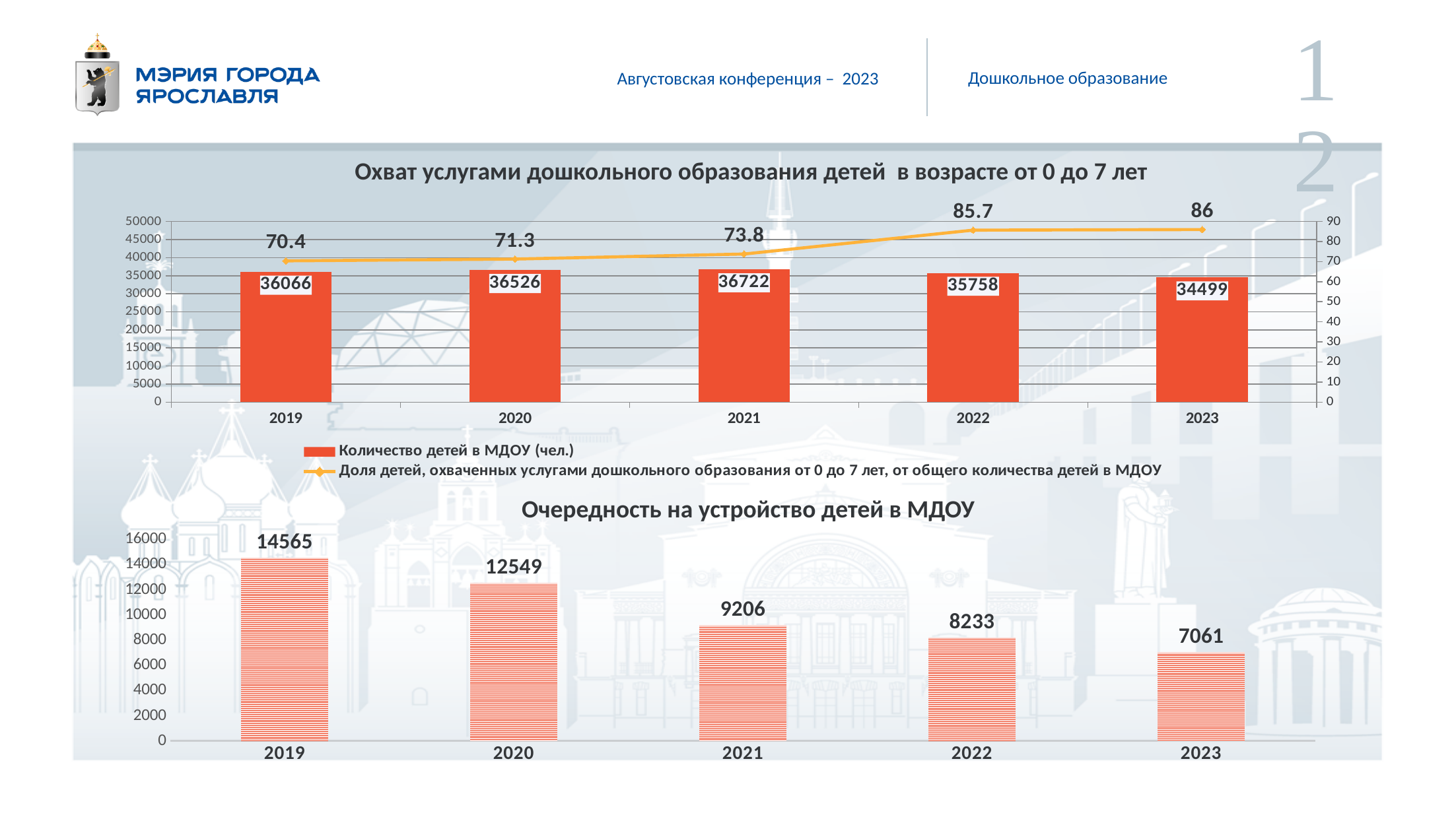
In the bottom chart 'Очередность на устройство детей в МДОУ', which year has the highest value? 2019 In the bottom chart 'Очередность на устройство детей в МДОУ', what is the difference between the values for 2019 and 2023? 7504 How many series does the legend of the top chart 'Охват услугами дошкольного образования детей в возрасте от 0 до 7 лет' list? 2 What kind of chart is the bottom chart 'Очередность на устройство детей в МДОУ'? bar chart In the top chart 'Охват услугами дошкольного образования детей в возрасте от 0 до 7 лет', does the share of children covered by preschool education rise or fall from 2019 to 2023? rise In the top chart 'Охват услугами дошкольного образования детей в возрасте от 0 до 7 лет', what colour is the line showing the share of children covered by preschool education? orange In the top chart 'Охват услугами дошкольного образования детей в возрасте от 0 до 7 лет', what is the difference between the number of children in МДОУ in 2019 and in 2023? 1567 In the top chart 'Охват услугами дошкольного образования детей в возрасте от 0 до 7 лет', what is the share of children covered by preschool education services in 2022? 85.7 In the bottom chart 'Очередность на устройство детей в МДОУ', is the value for 2021 greater or less than 10000? less In the bottom chart 'Очередность на устройство детей в МДОУ', what is the value for 2020? 12549 In the top chart 'Охват услугами дошкольного образования детей в возрасте от 0 до 7 лет', which year has the lowest number of children in МДОУ? 2023 In the top chart 'Охват услугами дошкольного образования детей в возрасте от 0 до 7 лет', what is the number of children in МДОУ in 2021? 36722